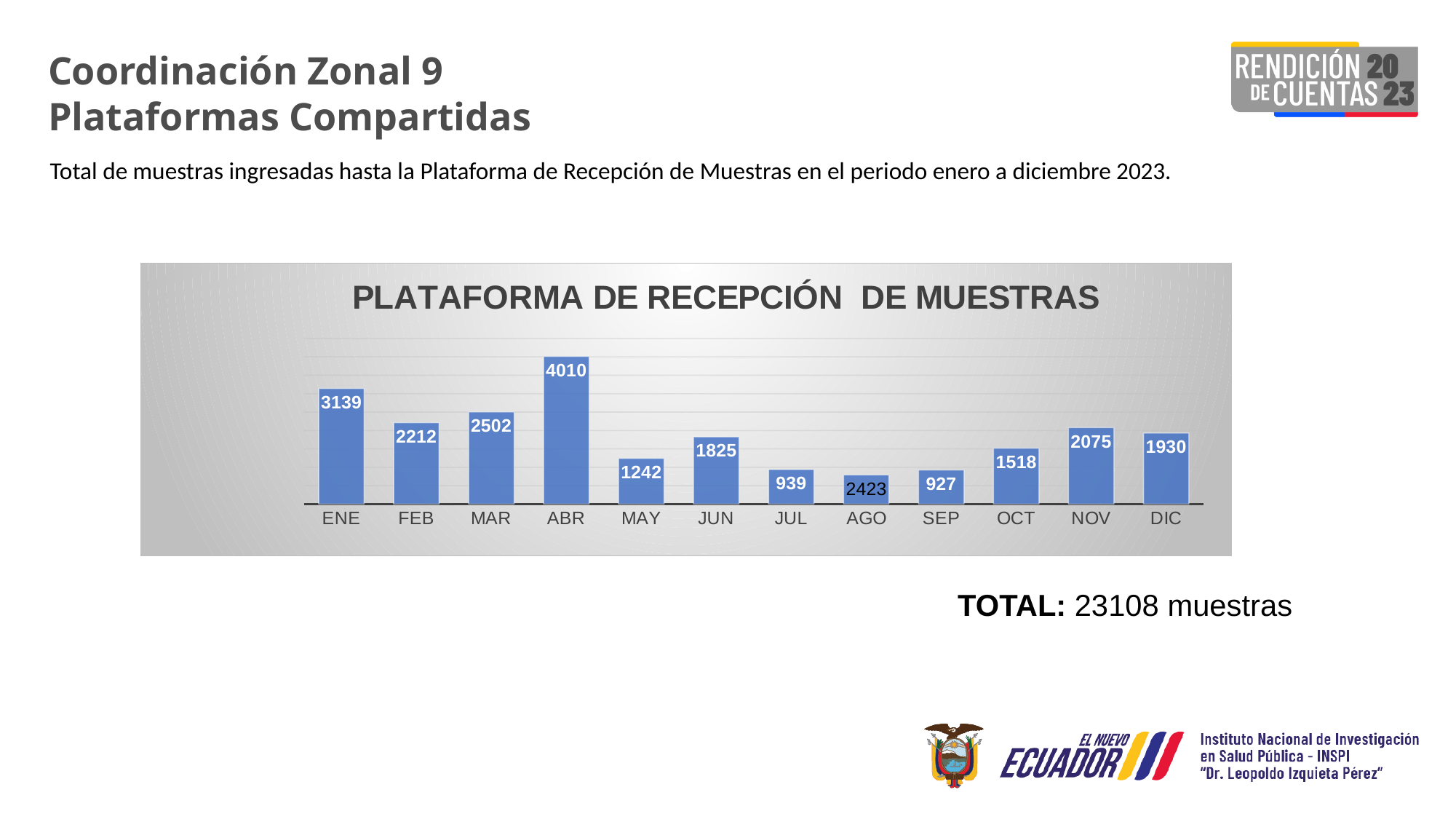
How many months are plotted in the chart? 12 What is the difference between the values for ENE and FEB? 927 What is the value for ENE? 3139 Which month has the highest value in the chart? ABR What is the value for ABR? 4010 What kind of chart is shown on the slide? bar chart What is the title of the chart? PLATAFORMA DE RECEPCIÓN DE MUESTRAS Do the values rise or fall from SEP to NOV? rise What is the value for JUN? 1825 Which is larger, the value for MAR or the value for FEB? MAR What is the difference between the values for NOV and DIC? 145 What is the value for OCT? 1518